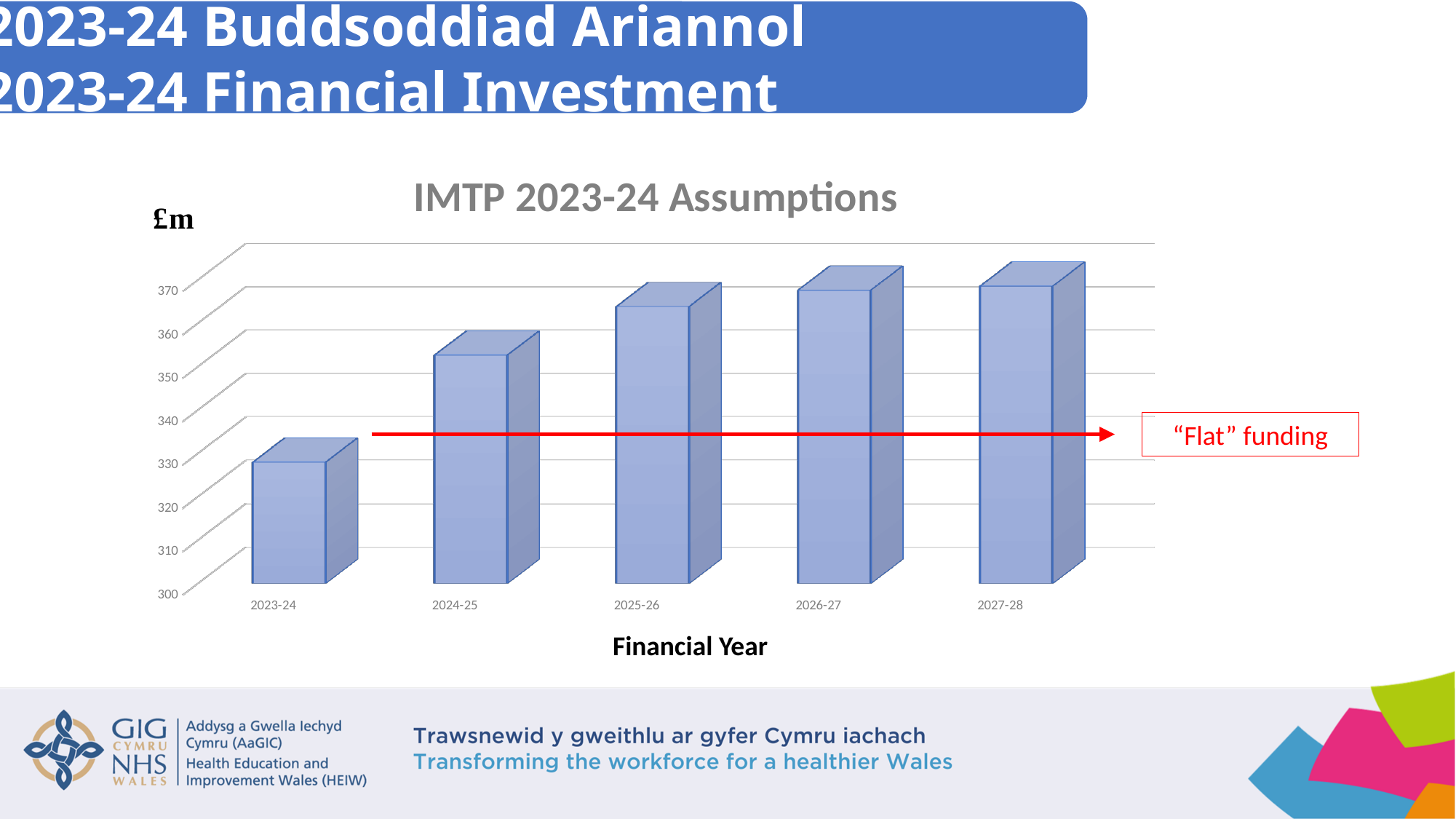
Is the value for 2023-24 greater or less than 340? less Which is larger, the value for 2024-25 or the value for 2025-26? 2025-26 Do the values rise or fall from 2023-24 to 2027-28? rise Is the value for 2027-28 greater or less than 360? greater How many financial years are plotted on the chart? 5 Is the value for 2025-26 greater or less than 360? greater What is the title of the chart? IMTP 2023-24 Assumptions What is the label on the x axis of the chart? Financial Year What type of chart is shown on the slide? bar chart Which is larger, the value for 2023-24 or the value for 2024-25? 2024-25 Which financial year has the lowest value on the chart? 2023-24